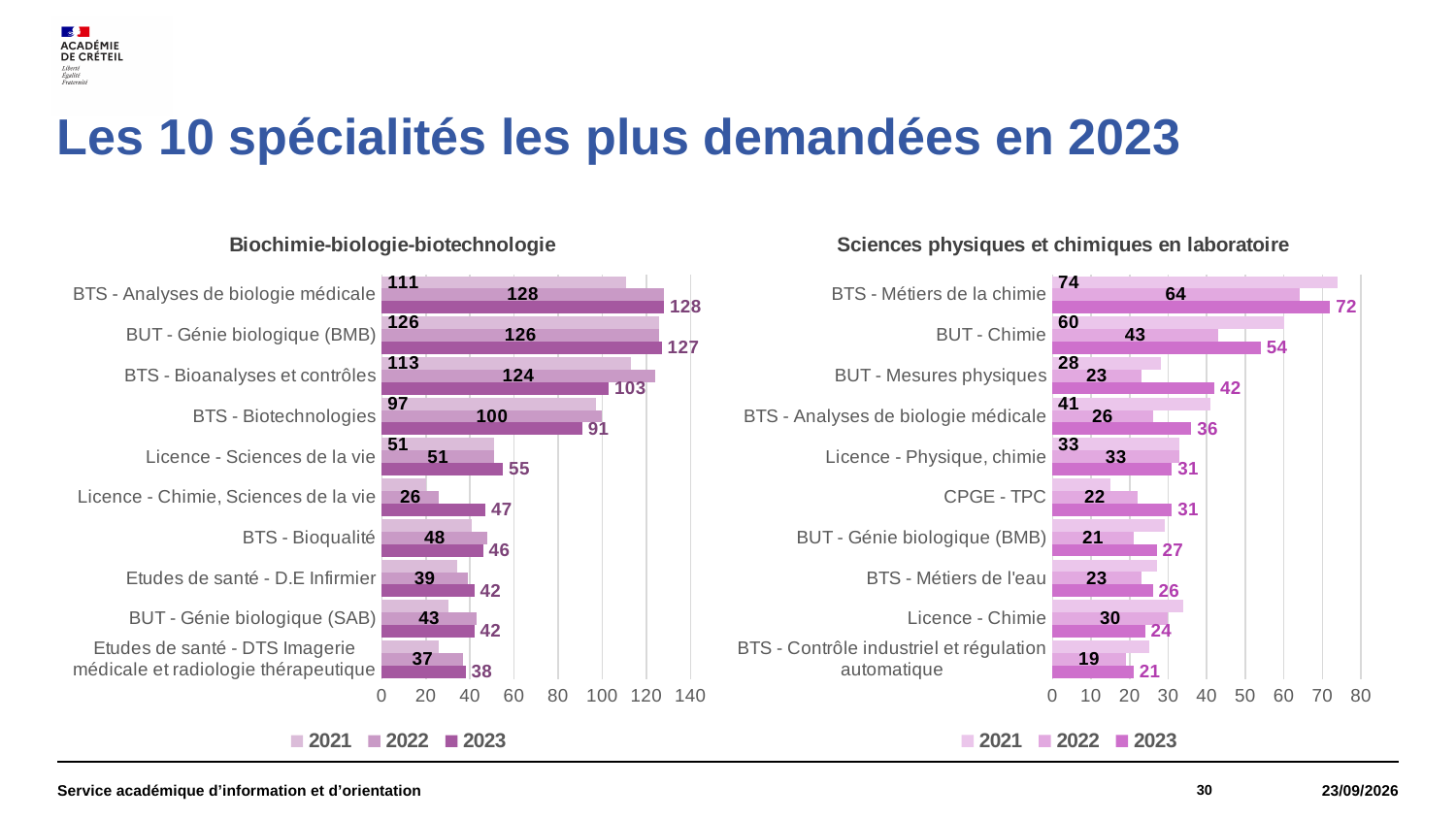
What kind of chart is the 'Biochimie-biologie-biotechnologie' chart? bar chart In the 'Biochimie-biologie-biotechnologie' chart, what is the difference between the 2023 values for BUT - Génie biologique (BMB) and BTS - Biotechnologies? 36 What is the title of the chart on the right side of the slide? Sciences physiques et chimiques en laboratoire In the 'Sciences physiques et chimiques en laboratoire' chart, what is the 2021 value for BTS - Métiers de la chimie? 74 In the 'Sciences physiques et chimiques en laboratoire' chart, which has the larger 2023 value: BUT - Chimie or BUT - Mesures physiques? BUT - Chimie In the 'Biochimie-biologie-biotechnologie' chart, what is the 2023 value for BTS - Biotechnologies? 91 In the 'Biochimie-biologie-biotechnologie' chart, is the 2023 value for BTS - Analyses de biologie médicale greater or less than 120? greater How many series does the legend of the 'Sciences physiques et chimiques en laboratoire' chart list? 3 How many categories are shown in the 'Biochimie-biologie-biotechnologie' chart? 10 In the 'Sciences physiques et chimiques en laboratoire' chart, which category has the highest 2023 value? BTS - Métiers de la chimie In the 'Sciences physiques et chimiques en laboratoire' chart, what is the 2022 value for BUT - Chimie? 43 In the 'Biochimie-biologie-biotechnologie' chart, which category has the lowest 2023 value? Etudes de santé - DTS Imagerie médicale et radiologie thérapeutique